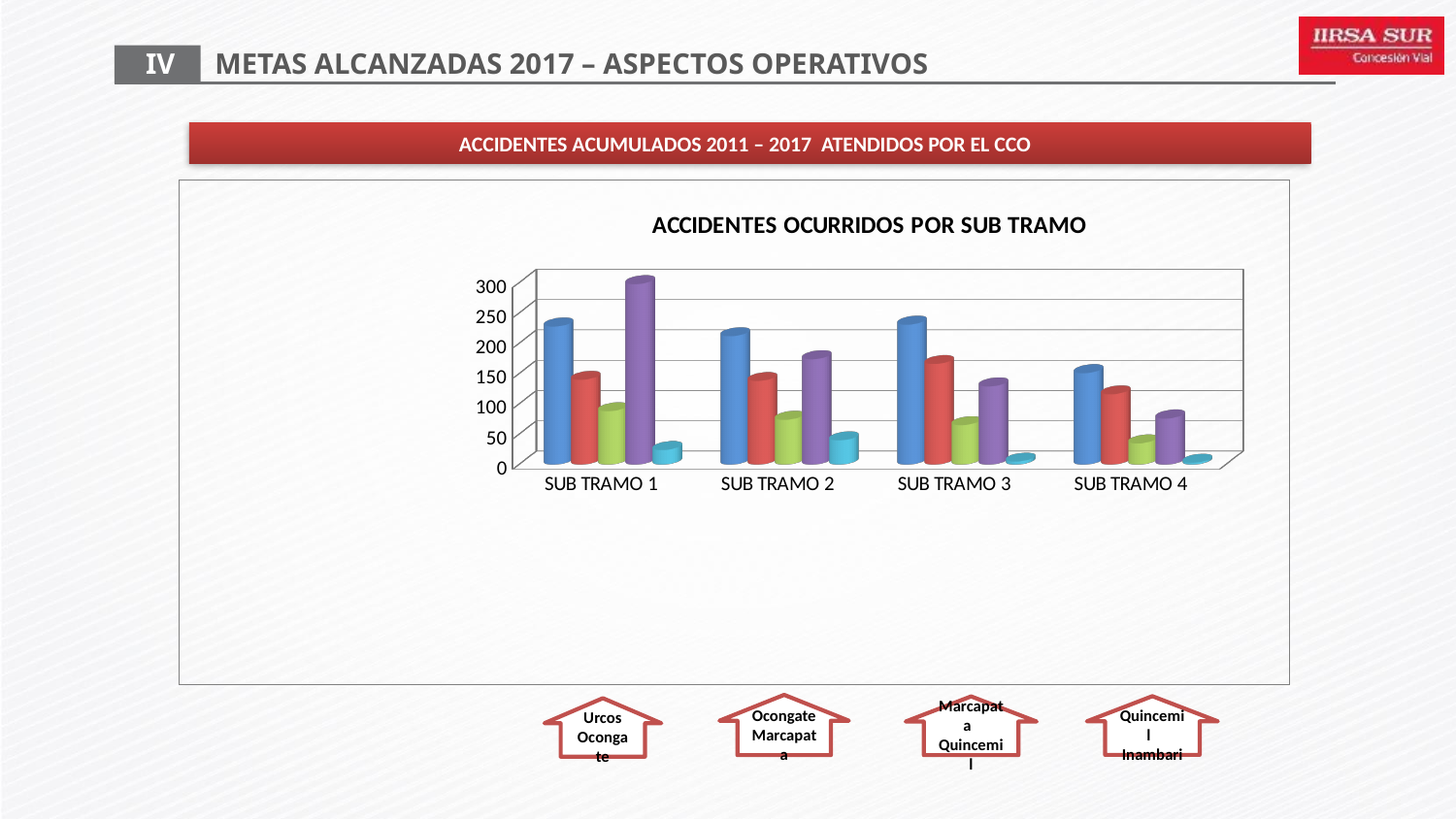
For SUB TRAMO 3, which is larger, the blue bar or the purple bar? the blue bar Is the value of the light blue bar for SUB TRAMO 2 greater or less than 50? less Is the value of the purple bar for SUB TRAMO 1 greater or less than 250? greater Which sub tramo has the shortest blue bar? SUB TRAMO 4 What is the title of the chart? ACCIDENTES OCURRIDOS POR SUB TRAMO What kind of chart is shown on the slide? bar chart Is the value of the green bar for SUB TRAMO 3 greater or less than 100? less How many bars are plotted for each sub tramo category? 5 How many sub tramo categories are shown on the x axis? 4 Do the purple bars rise or fall from SUB TRAMO 1 to SUB TRAMO 4? fall Which sub tramo has the tallest purple bar? SUB TRAMO 1